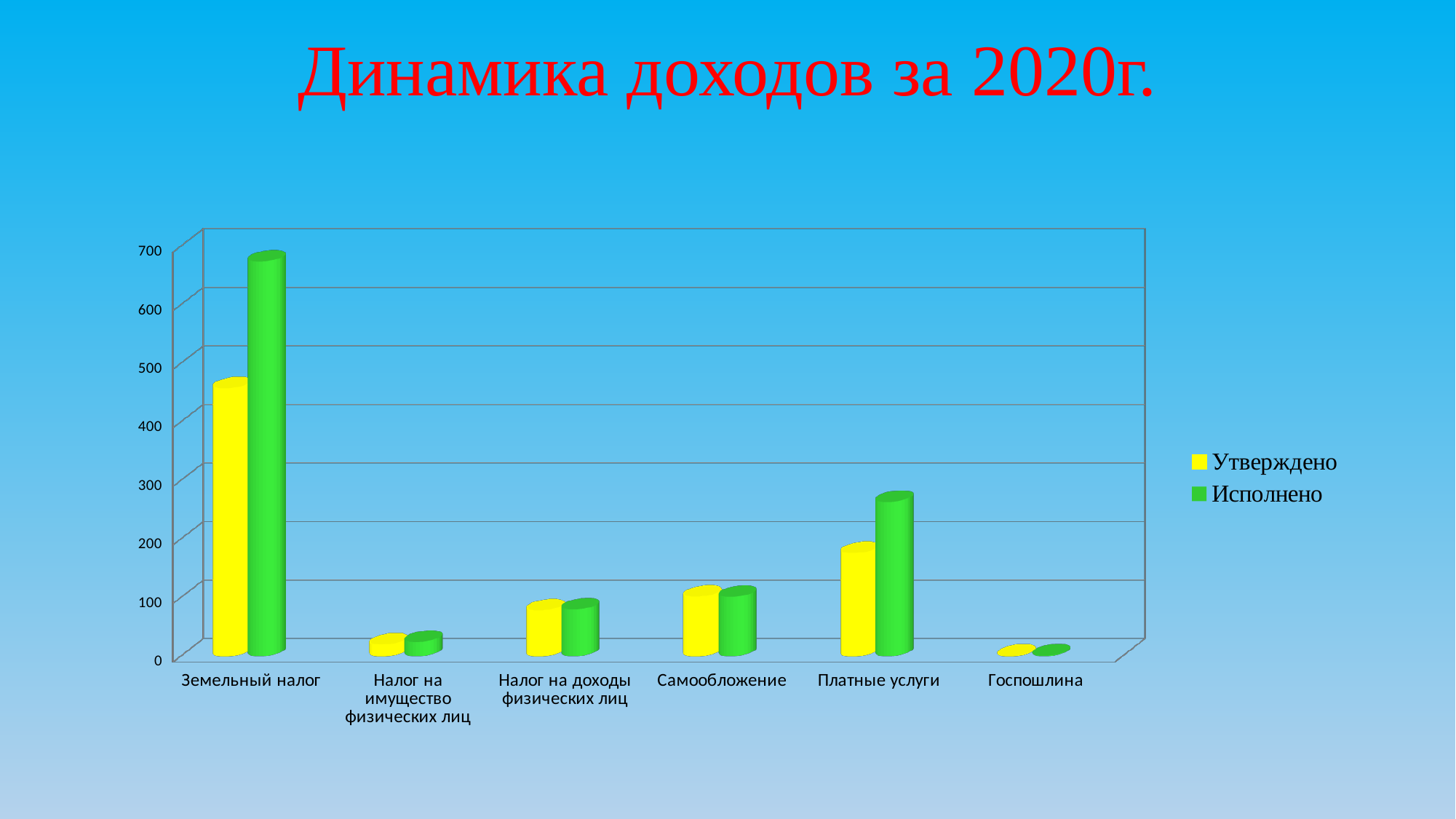
How many series does the legend list? 2 Which category has the lowest Утверждено value? Госпошлина For Платные услуги, which is larger: Утверждено or Исполнено? Исполнено Is the Исполнено value for Земельный налог greater or less than 600? greater How many categories are shown on the x axis? 6 Is the Утверждено value for Налог на имущество физических лиц greater or less than 100? less For Земельный налог, which is larger: Утверждено or Исполнено? Исполнено What is the title of the chart? Динамика доходов за 2020г. Is the Утверждено value for Земельный налог greater or less than 400? greater What type of chart is shown on the slide? bar chart Which colour represents the series Исполнено? green Which category has the highest Исполнено value? Земельный налог